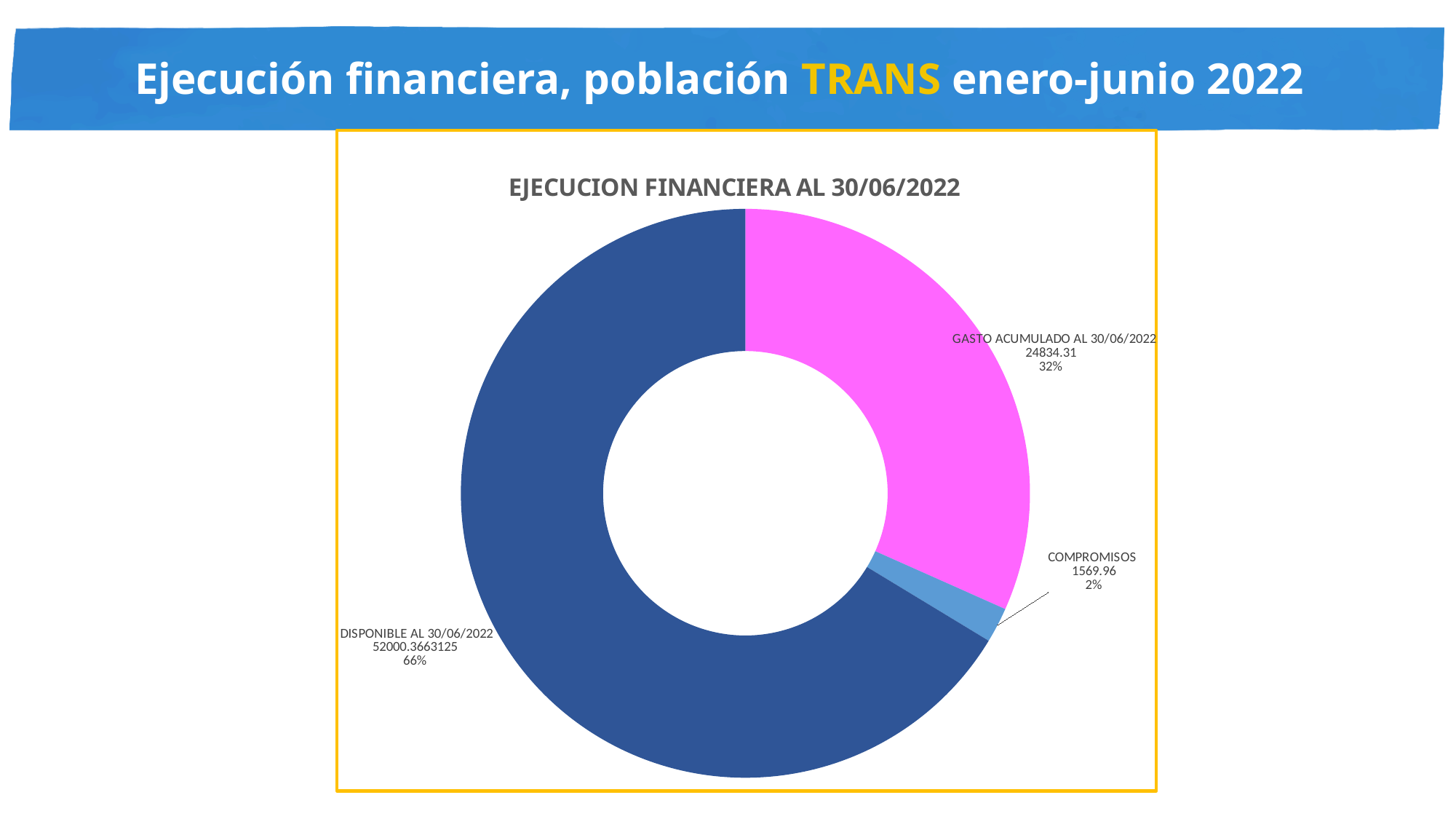
Which category has the largest slice? DISPONIBLE AL 30/06/2022 What is the value for DISPONIBLE AL 30/06/2022? 52000.3663125 What share of the chart does GASTO ACUMULADO AL 30/06/2022 represent? 32% What share of the chart does DISPONIBLE AL 30/06/2022 represent? 66% Which is larger, GASTO ACUMULADO AL 30/06/2022 or COMPROMISOS? GASTO ACUMULADO AL 30/06/2022 What is the title of the chart? EJECUCION FINANCIERA AL 30/06/2022 What is the value for GASTO ACUMULADO AL 30/06/2022? 24834.31 How many slices does the chart have? 3 What type of chart is shown on the slide? Doughnut chart What is the value for COMPROMISOS? 1569.96 Which category has the smallest slice? COMPROMISOS What share of the chart does COMPROMISOS represent? 2%